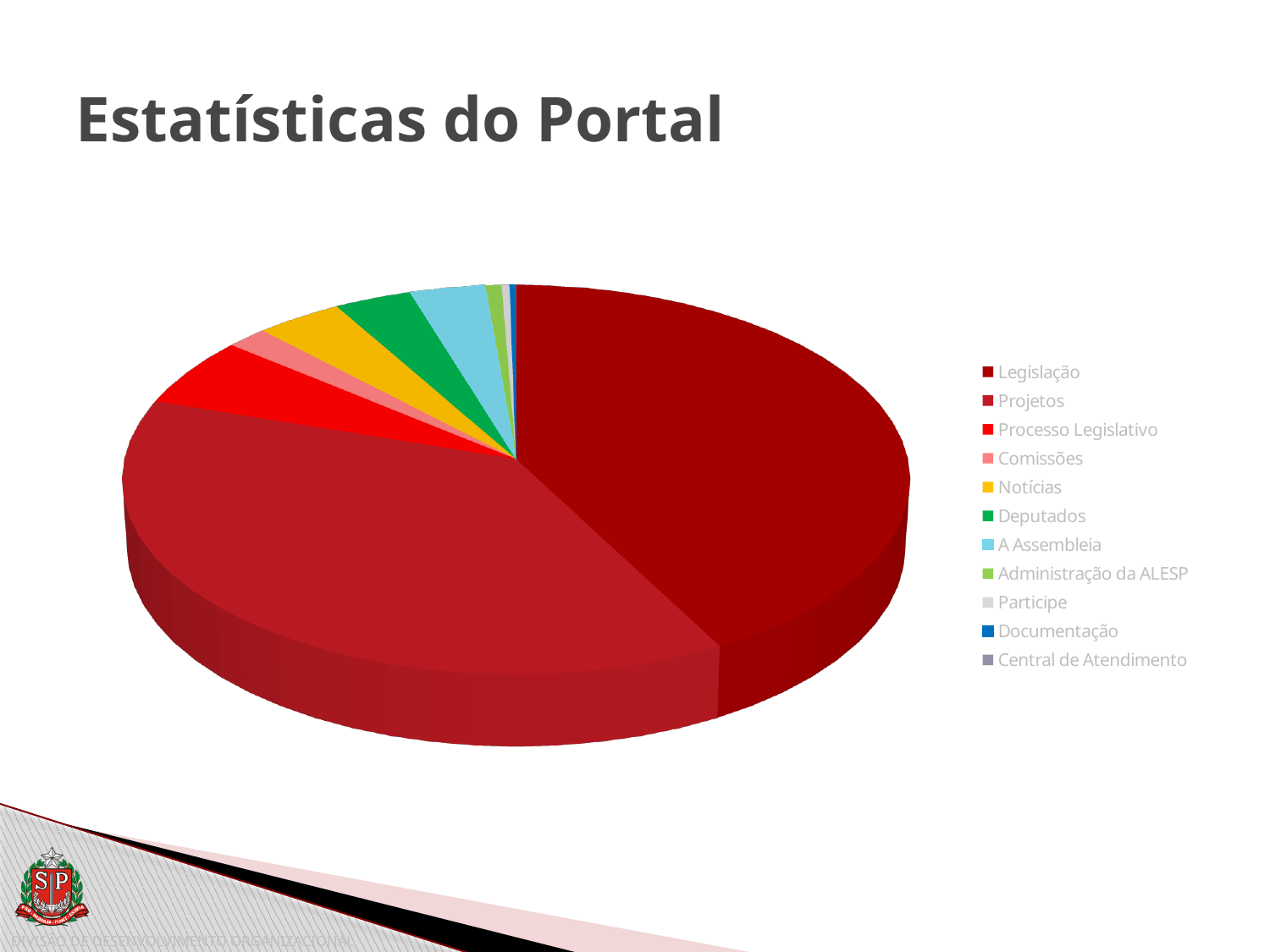
Which category is larger in the pie chart, Notícias or Comissões? Notícias Which category is larger in the pie chart, A Assembleia or Documentação? A Assembleia Which category is larger in the pie chart, Deputados or Administração da ALESP? Deputados What is the title of the slide containing the pie chart? Estatísticas do Portal How many categories does the legend of the pie chart list? 11 What kind of chart is shown on the slide? pie chart Which category is listed first in the pie chart legend? Legislação What colour represents Notícias in the pie chart legend? yellow